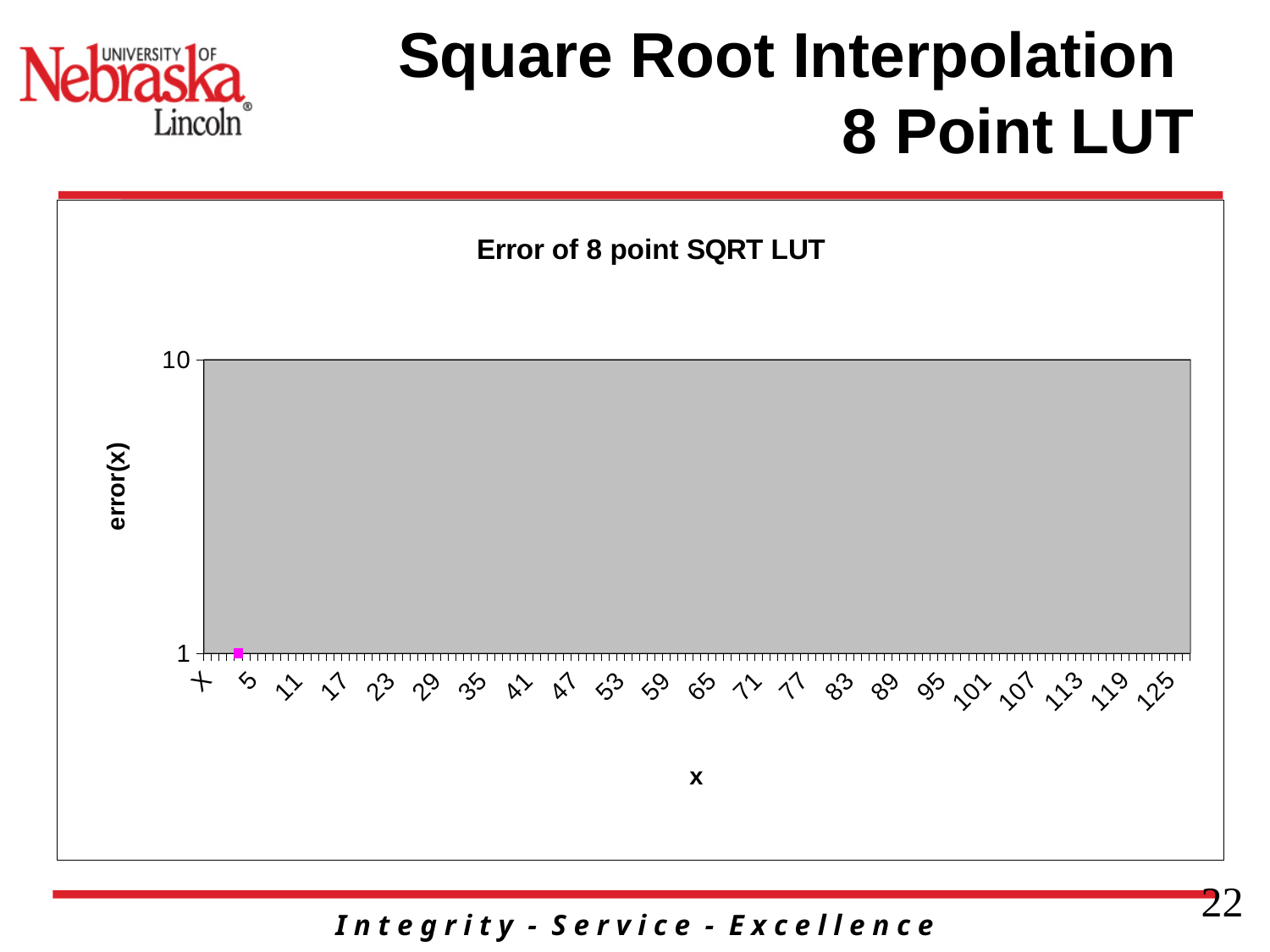
Is the value of the plotted point near x = 3 greater or less than 10? less What is the label on the vertical axis of the chart? error(x) What is the title of the chart? Error of 8 point SQRT LUT